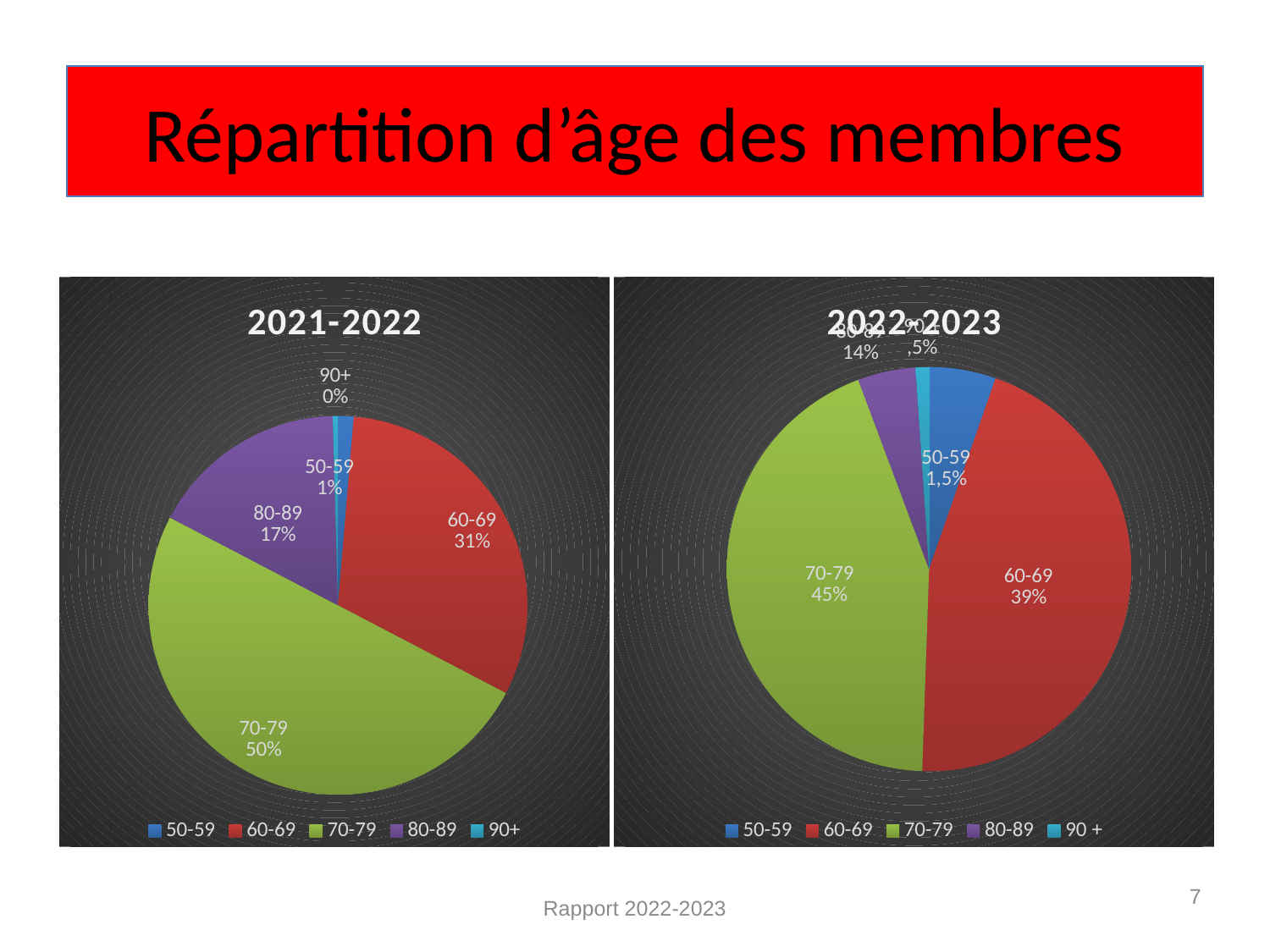
In the 2021-2022 chart, what share of members are aged 70-79? 50% In the 2022-2023 chart, which age group has the largest share? 70-79 In the 2022-2023 chart, which is larger, the 60-69 share or the 80-89 share? 60-69 In the 2022-2023 chart, what share of members are aged 60-69? 39% In the 2021-2022 chart, what is the difference between the 70-79 share and the 60-69 share? 19% In the 2022-2023 chart, what percentage is shown for the 80-89 age group? 14% In the 2021-2022 chart, what percentage is shown for the 90+ age group? 0% In the 2022-2023 chart, what percentage is shown for the 50-59 age group? 1,5% In the 2021-2022 chart, what percentage is shown for the 60-69 age group? 31% In the 2021-2022 chart, what percentage is shown for the 80-89 age group? 17% In the 2021-2022 chart, which age group has the largest share? 70-79 How many entries does the legend of the 2021-2022 chart list? 5